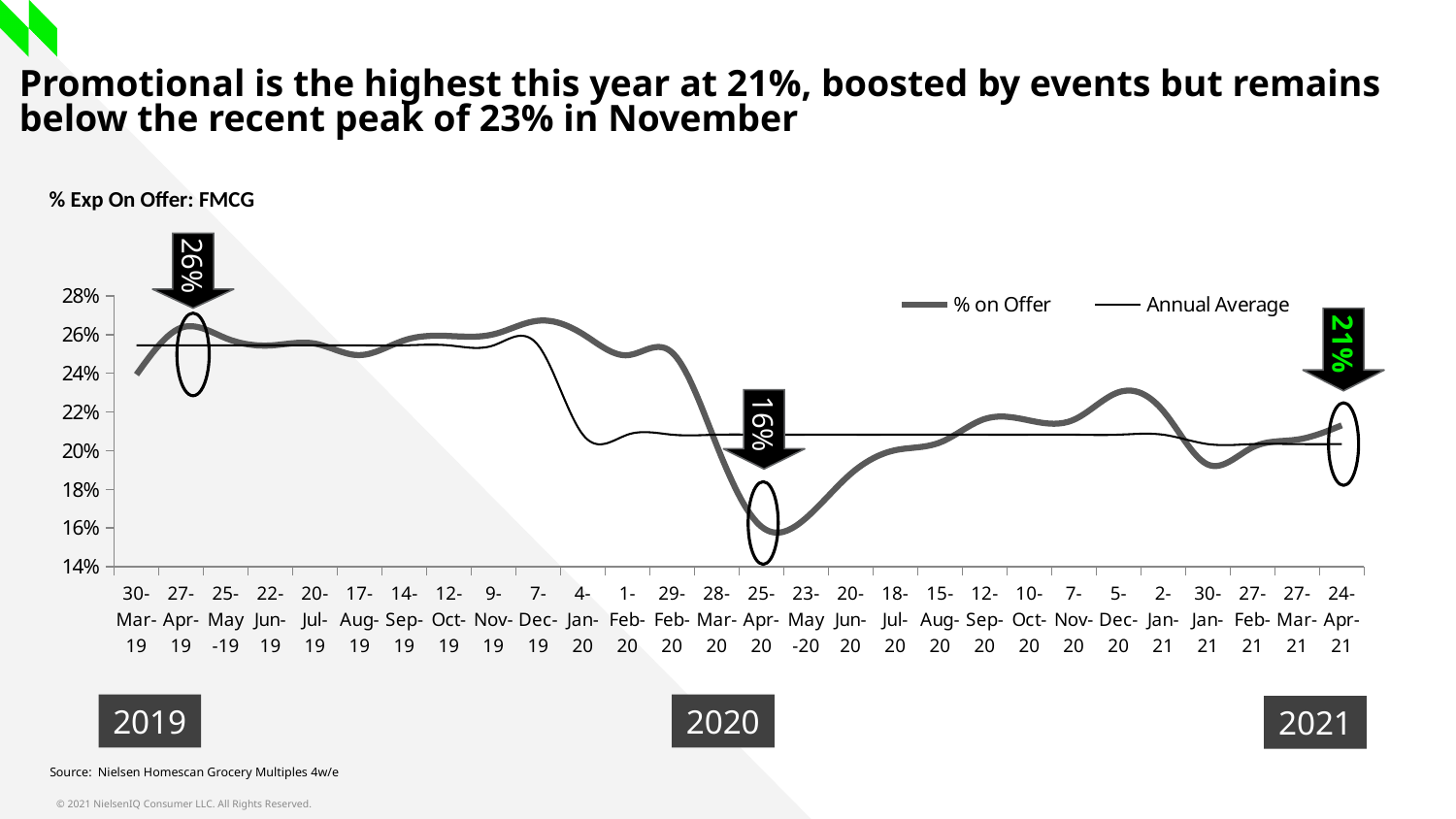
What is the annotated % on Offer value at 27-Apr-19? 26% Which is larger, the annotated % on Offer value at 27-Apr-19 or at 24-Apr-21? 27-Apr-19 How many dates are shown on the x axis? 28 How many series does the chart legend list? 2 What is the annotated % on Offer value at 25-Apr-20? 16% Is the % on Offer value at 30-Jan-21 greater or less than 20%? less What is the annotated % on Offer value at 24-Apr-21? 21% What are the two series named in the chart legend? % on Offer and Annual Average What is the title of the chart? % Exp On Offer: FMCG What kind of chart is shown on the slide? line chart What is the difference between the annotated % on Offer values at 27-Apr-19 and 25-Apr-20? 10 percentage points At which date does the % on Offer line reach its lowest point? 25-Apr-20